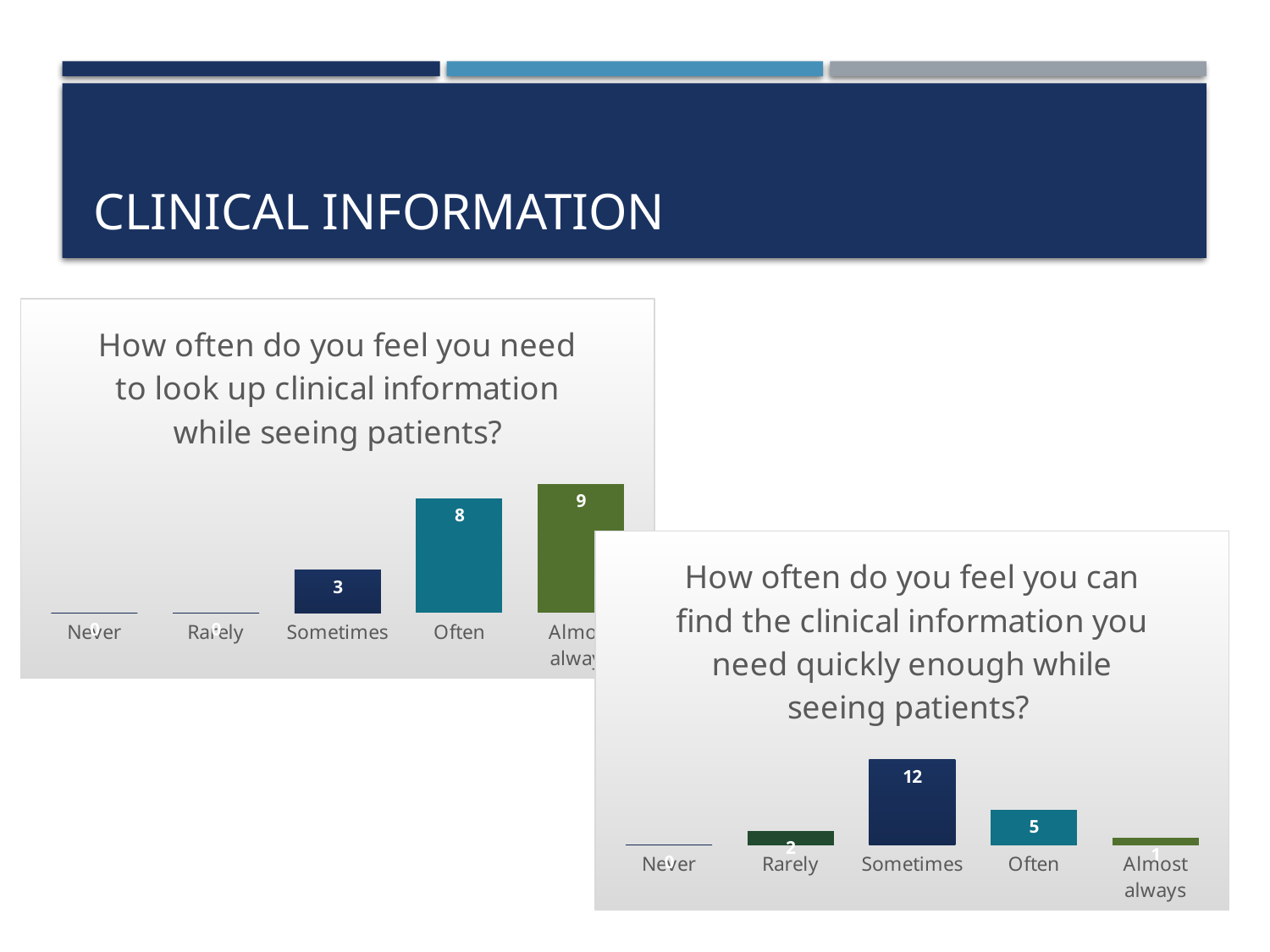
In the chart titled "How often do you feel you need to look up clinical information while seeing patients?", what is the value for Often? 8 In the chart titled "How often do you feel you can find the clinical information you need quickly enough while seeing patients?", which is larger, the value for Rarely or the value for Often? Often In the chart titled "How often do you feel you need to look up clinical information while seeing patients?", which is larger, the value for Sometimes or the value for Often? Often In the chart titled "How often do you feel you need to look up clinical information while seeing patients?", what is the value for Never? 0 In the chart titled "How often do you feel you can find the clinical information you need quickly enough while seeing patients?", what is the value for Often? 5 In the chart titled "How often do you feel you can find the clinical information you need quickly enough while seeing patients?", what is the difference between the values for Sometimes and Often? 7 What kind of chart is the chart titled "How often do you feel you can find the clinical information you need quickly enough while seeing patients?"? Bar chart In the chart titled "How often do you feel you can find the clinical information you need quickly enough while seeing patients?", what is the value for Sometimes? 12 In the chart titled "How often do you feel you need to look up clinical information while seeing patients?", what is the value for Sometimes? 3 In the chart titled "How often do you feel you need to look up clinical information while seeing patients?", what is the difference between the values for Often and Sometimes? 5 In the chart titled "How often do you feel you can find the clinical information you need quickly enough while seeing patients?", which category has the highest value? Sometimes In the chart titled "How often do you feel you can find the clinical information you need quickly enough while seeing patients?", how many categories are shown on the x axis? 5